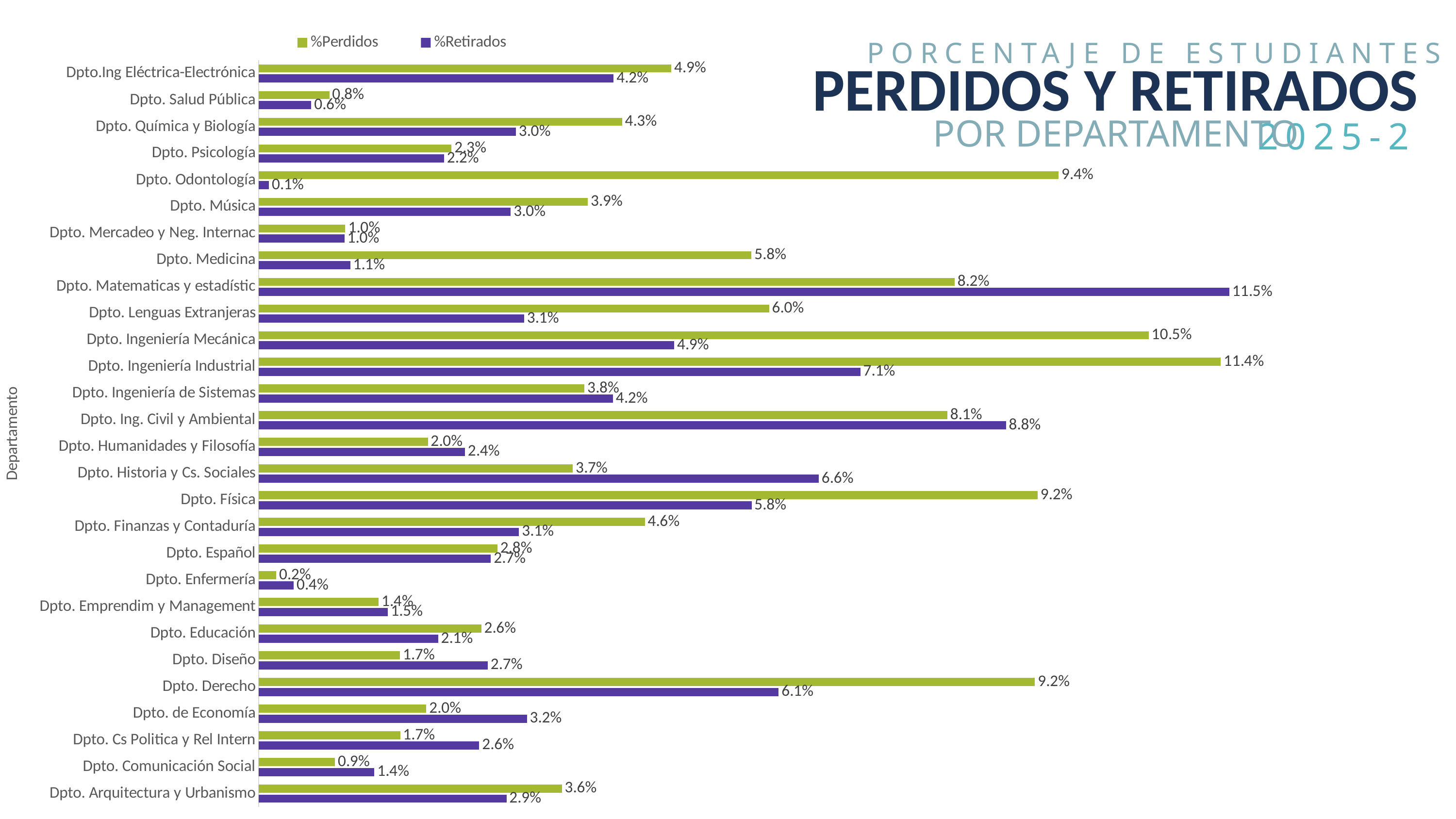
Which department has the lowest %Retirados value? Dpto. Odontología What is the %Retirados value for Dpto. Derecho? 6.1% How many series does the legend list? 2 Which department has the lowest %Perdidos value? Dpto. Enfermería What kind of chart is shown on the slide? Bar chart Which is larger for Dpto. Ing. Civil y Ambiental, %Perdidos or %Retirados? %Retirados What is the %Perdidos value for Dpto. Odontología? 9.4% Which department has the highest %Perdidos value? Dpto. Ingeniería Industrial What is the %Retirados value for Dpto. Matematicas y estadístic? 11.5% How many departments are shown on the chart? 28 What is the difference between %Perdidos and %Retirados for Dpto. Odontología? 9.3 percentage points What is the %Perdidos value for Dpto. Ingeniería Mecánica? 10.5%